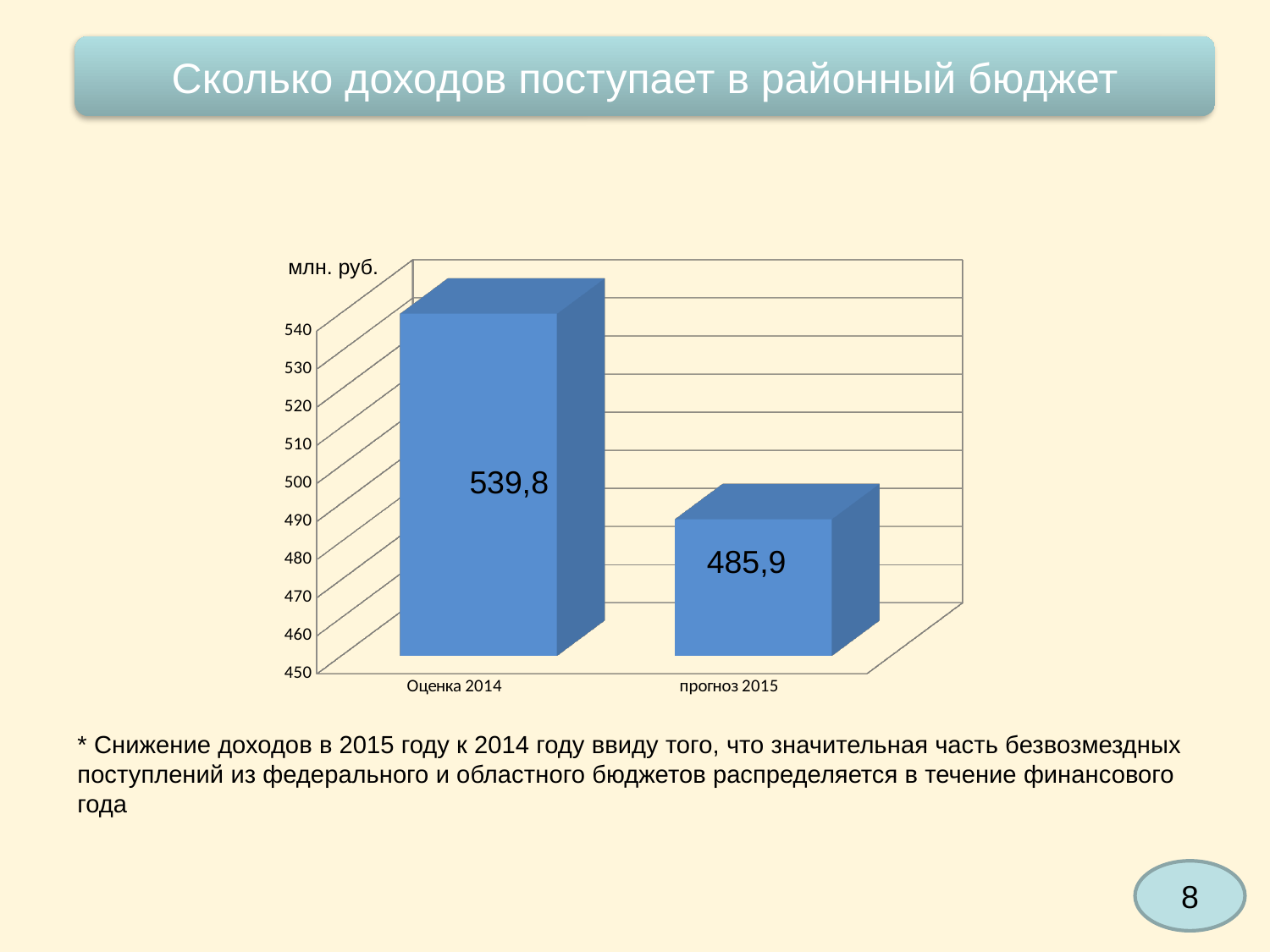
Is the value for Оценка 2014 greater or less than 530? greater Do the values rise or fall from Оценка 2014 to прогноз 2015? fall What kind of chart is shown on the slide? bar chart What is the value for Оценка 2014? 539,8 How many categories are shown in the chart? 2 What is the value for прогноз 2015? 485,9 Which is larger, the value for Оценка 2014 or the value for прогноз 2015? Оценка 2014 Which category has the highest value? Оценка 2014 What is the difference between the values for Оценка 2014 and прогноз 2015? 53,9 Which category has the lowest value? прогноз 2015 What unit is shown on the chart's vertical axis? млн. руб. Is the value for прогноз 2015 greater or less than 500? less